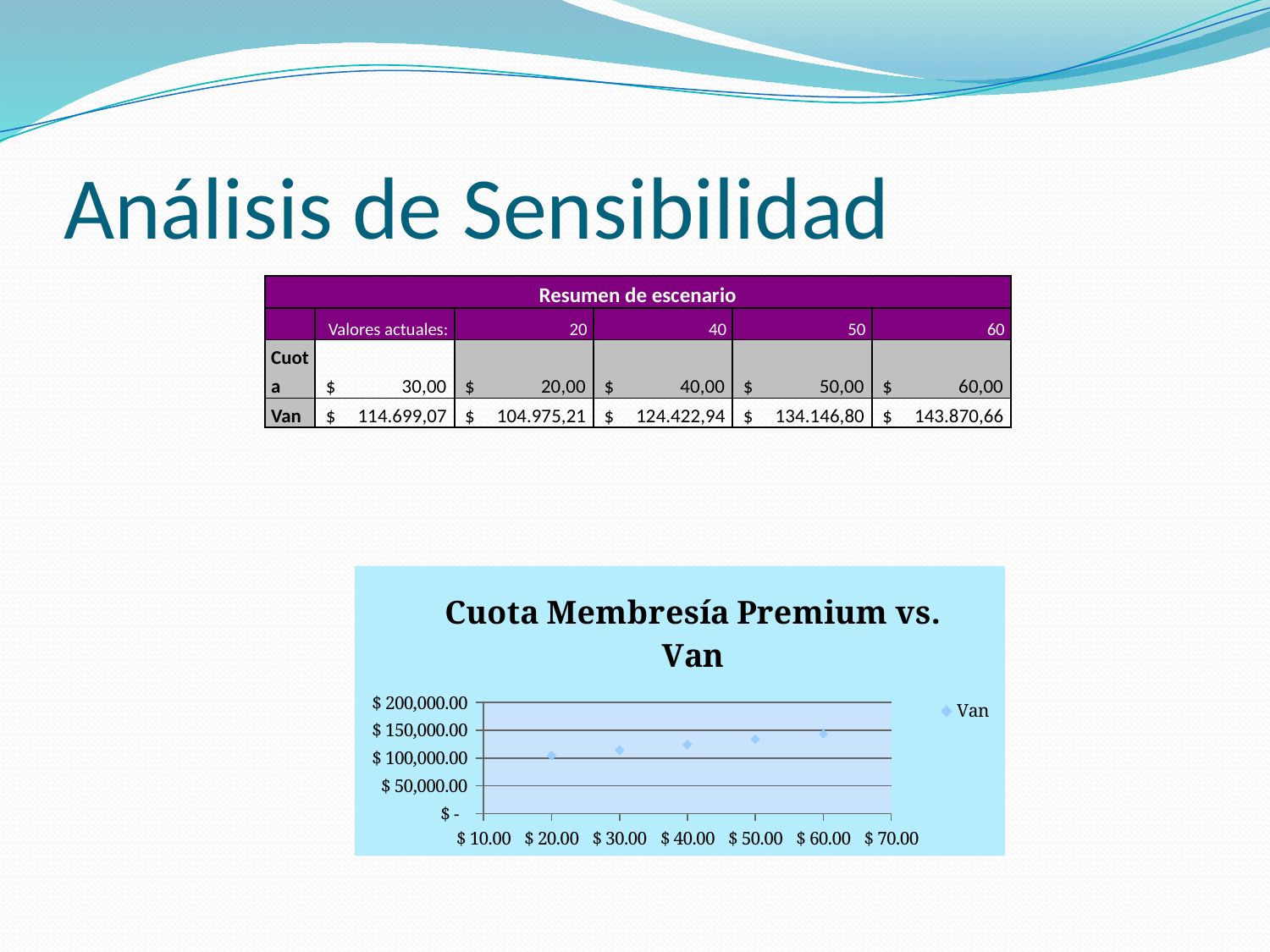
How many series does the chart legend list? 1 Do the Van values rise or fall as the cuota increases along the x axis? Rise At which cuota value is the plotted Van value highest? $ 60.00 How many data points are plotted in the chart? 5 Is the Van value at a cuota of $ 40.00 greater or less than $ 100,000.00? greater At which cuota value is the plotted Van value lowest? $ 20.00 Is the Van value at a cuota of $ 60.00 greater or less than $ 100,000.00? greater Which has the larger Van value in the chart: a cuota of $ 50.00 or a cuota of $ 30.00? $ 50.00 Is the Van value at a cuota of $ 20.00 greater or less than $ 150,000.00? less What is the title of the chart on the slide? Cuota Membresía Premium vs. Van What kind of chart is shown on the slide? Scatter chart What is the name of the series shown in the chart legend? Van